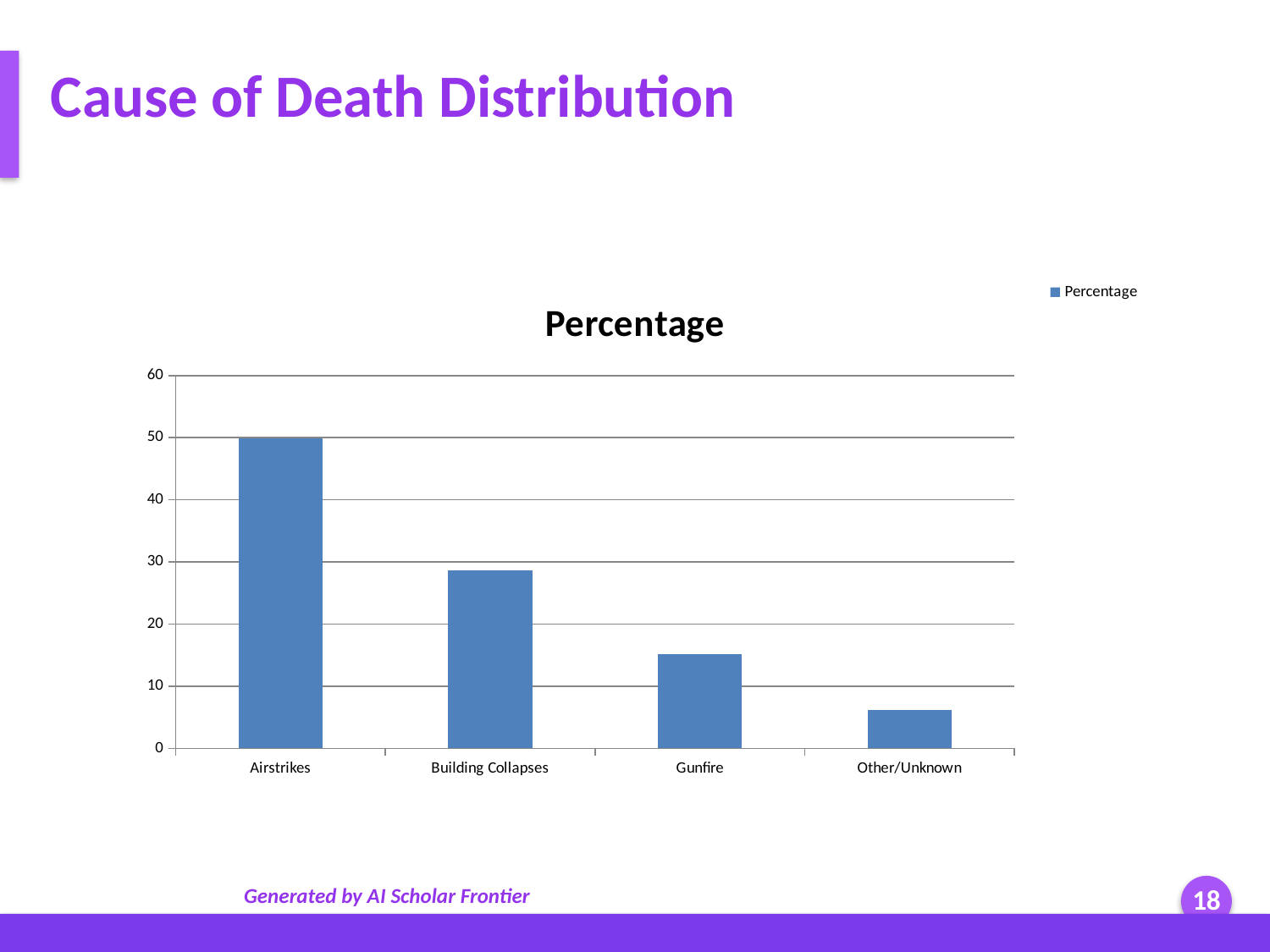
Which category has the highest value? Airstrikes Is the value for Other/Unknown greater or less than 10? less How many series does the legend list? 1 How many categories are shown on the x axis of the chart? 4 What is the title of the chart? Percentage Is the value for Gunfire greater or less than 10? greater Which category has the lowest value? Other/Unknown Is the value for Building Collapses greater or less than 30? less Which is larger, the value for Building Collapses or the value for Gunfire? Building Collapses Do the values rise or fall moving from left to right along the x axis? fall What kind of chart is shown on the slide? bar chart